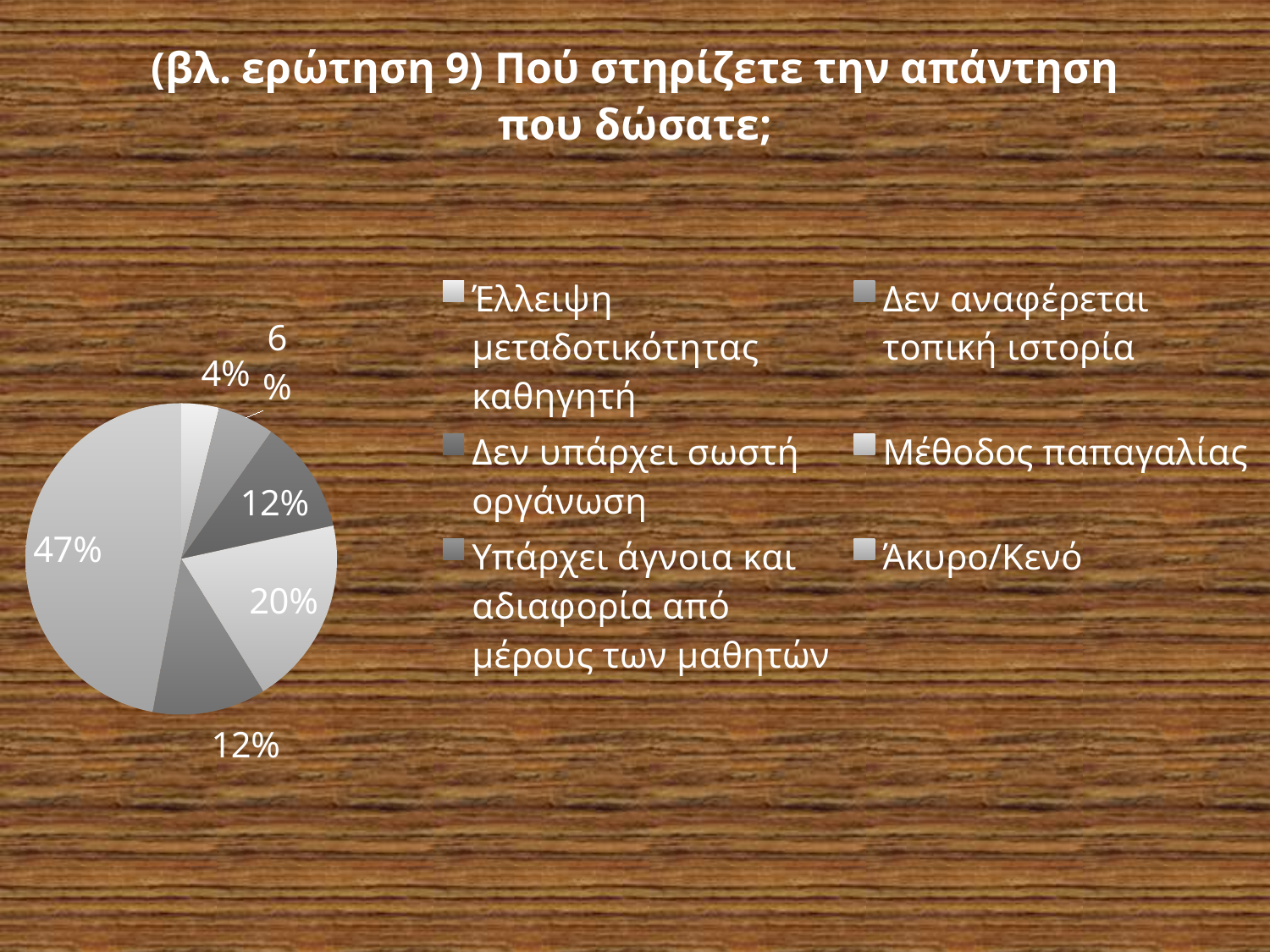
What kind of chart is shown on the slide? pie chart What is the percentage of the smallest slice in the pie chart? 4% Which is larger: the 20% slice or the 12% slice? the 20% slice What is the last entry listed in the legend of the pie chart? Άκυρο/Κενό What is the percentage of the largest slice in the pie chart? 47% How many slices does the pie chart have? 6 How many entries does the legend of the pie chart list? 6 What is the difference in percentage points between the largest slice (47%) and the smallest slice (4%)? 43 What is the title of the slide containing the pie chart? (βλ. ερώτηση 9) Πού στηρίζετε την απάντηση που δώσατε; What is the difference in percentage points between the 20% slice and the 6% slice? 14 How many slices in the pie chart are labelled 12%? 2 Is the largest slice of the pie chart greater or less than 50%? less